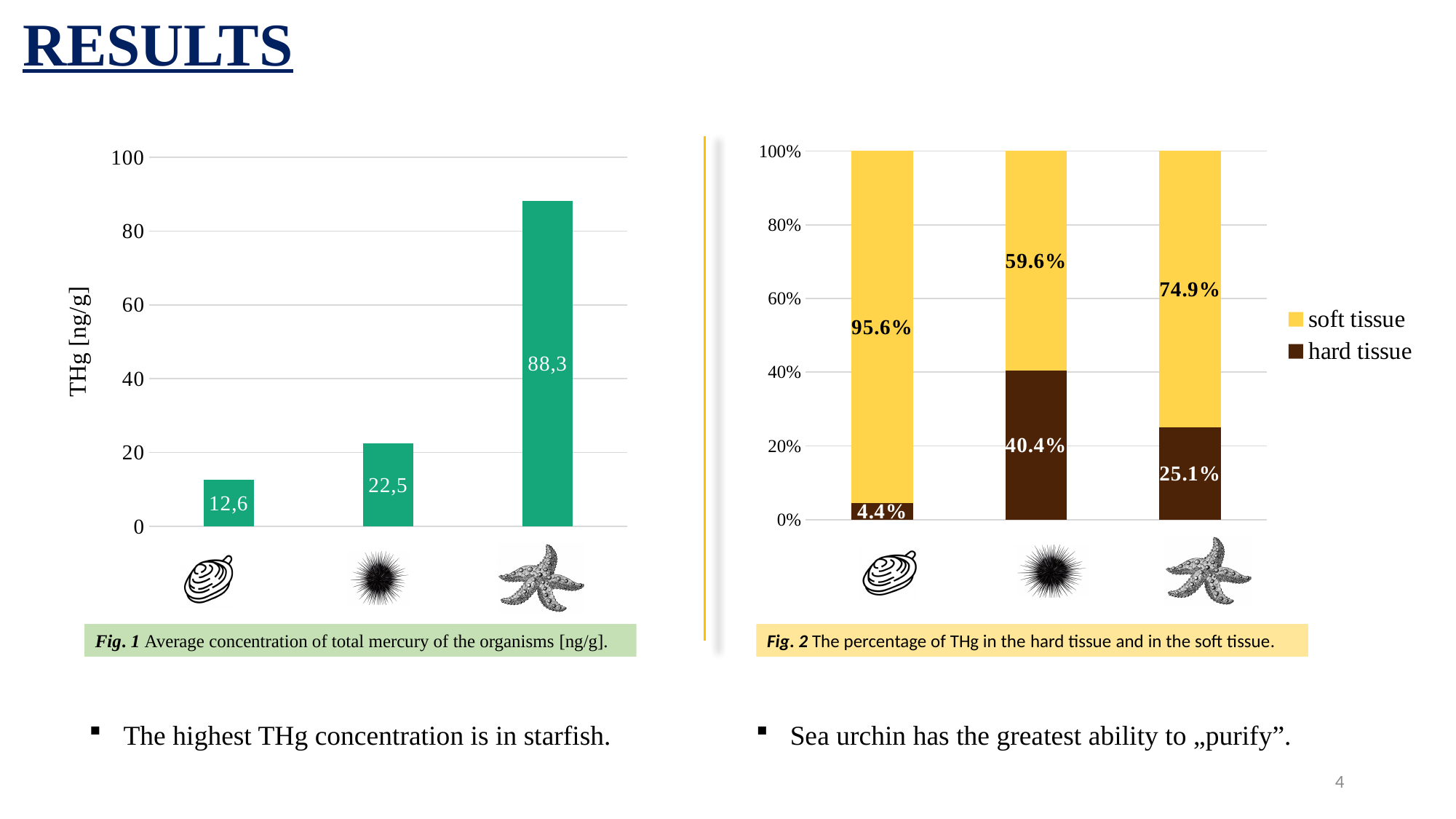
In Fig. 2, how many series does the legend list? 2 In Fig. 2, what are the two legend entries? soft tissue, hard tissue In Fig. 1, do the values rise or fall from left to right? Rise In Fig. 2, what percentage of THg is in the hard tissue for the middle bar (sea urchin)? 40.4% In Fig. 1, how many bars are plotted? 3 In Fig. 1, what is the value of the leftmost bar? 12,6 In Fig. 1, which bar has the highest THg concentration? The rightmost bar (starfish) In Fig. 2, which bar has the largest hard tissue percentage? The middle bar (sea urchin) In Fig. 2, what is the soft tissue percentage for the leftmost bar? 95.6% What type of chart is Fig. 1? Bar chart In Fig. 1, what is the THg concentration shown for the rightmost bar (the starfish)? 88,3 In Fig. 1, what is the difference between the rightmost bar (88,3) and the middle bar (22,5)? 65,8